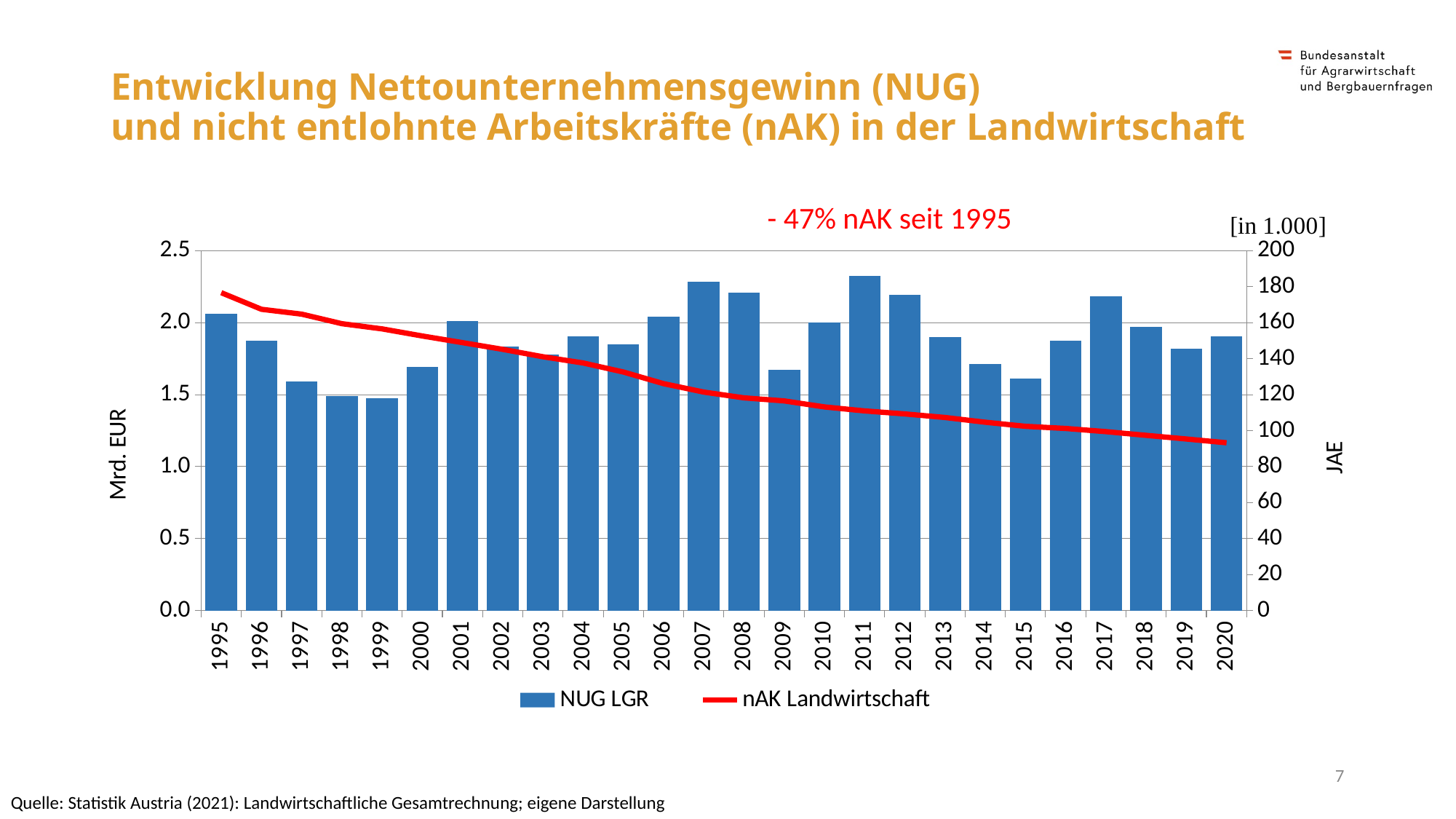
Is the nAK Landwirtschaft value for 2020 greater or less than 100? less Is the NUG LGR value for 2009 greater or less than 2.0? less Is the NUG LGR value for 1995 greater or less than 2.0? greater How many years are shown on the x axis of the chart? 26 What kind of chart is shown on the slide? A bar chart combined with a line Which year has the larger NUG LGR bar, 2007 or 2009? 2007 How many series does the chart legend list? 2 Does the nAK Landwirtschaft line rise or fall from 1995 to 2020? It falls What is the label of the left vertical axis? Mrd. EUR What are the two entries in the chart legend? NUG LGR and nAK Landwirtschaft